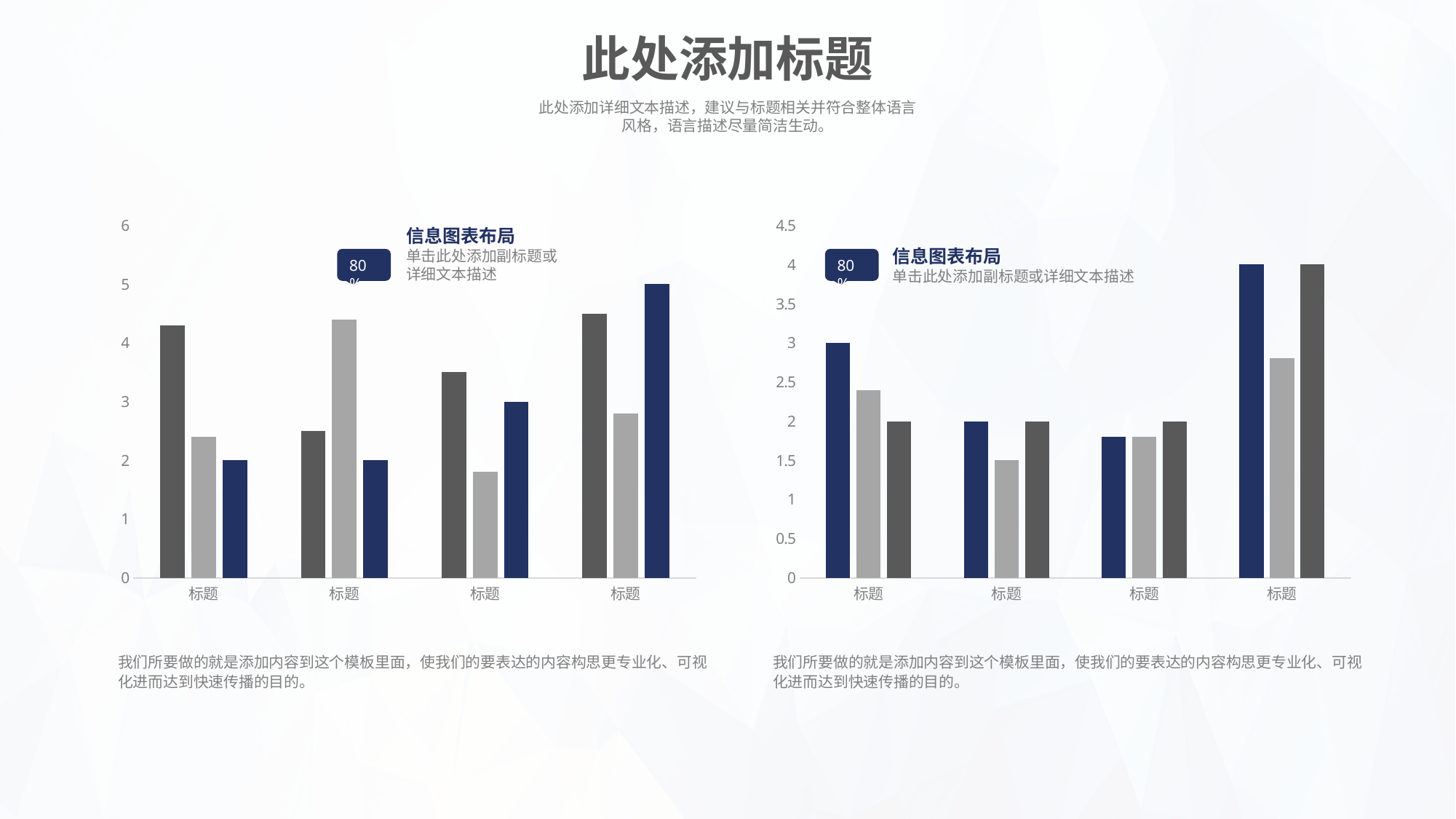
How many category groups are shown on the x axis of the chart on the right side of the slide? 4 In the chart on the left side of the slide, which bar is the tallest overall? the navy blue bar in the fourth category group In the chart on the left side of the slide, what is the value of the navy blue bar in the third category group? 3 In the chart on the right side of the slide, what is the value of the navy blue bar in the first category group? 3 What kind of chart is the chart on the left side of the slide? bar chart In the chart on the left side of the slide, how many bars are in each category group? 3 In the chart on the right side of the slide, is the light grey bar in the second category group greater or less than 2? less In the chart on the right side of the slide, which is larger in the first category group: the navy blue bar or the light grey bar? the navy blue bar In the chart on the left side of the slide, is the dark grey bar in the first category group greater or less than 4? greater In the chart on the right side of the slide, what is the value of the dark grey bar in the fourth (rightmost) category group? 4 What is the highest value shown on the y axis of the chart on the right side of the slide? 4.5 In the chart on the left side of the slide, what is the value of the navy blue bar in the fourth (rightmost) category group? 5